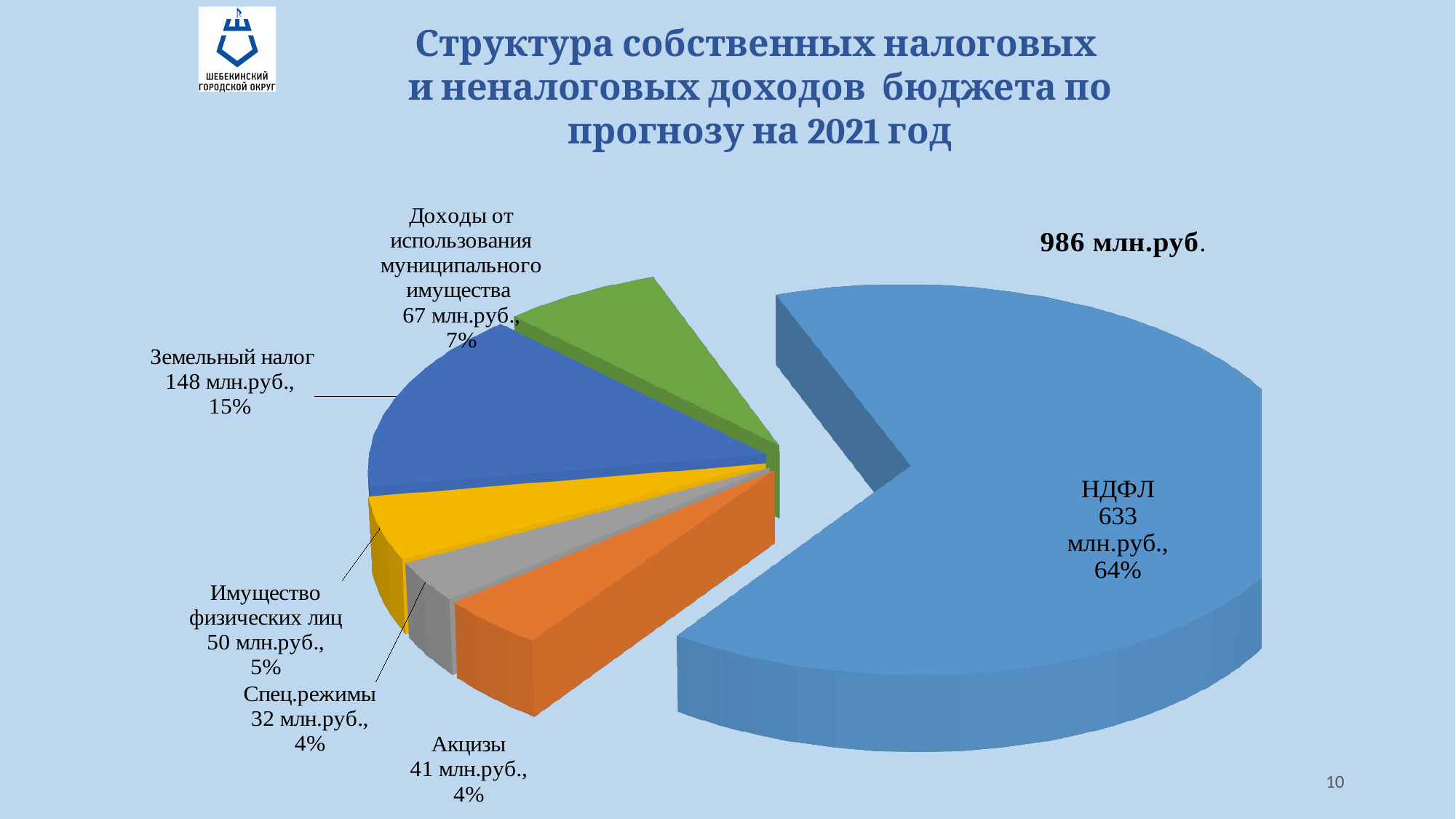
Which category has the smallest value? Спец.режимы Which category has the largest slice? НДФЛ How many slices does the pie chart have? 6 What is the value for Акцизы? 41 млн.руб. Which is larger, the value for Акцизы or the value for Спец.режимы? Акцизы What share of the pie does Доходы от использования муниципального имущества represent? 7% What total amount is shown on the slide for all own tax and non-tax revenues? 986 млн.руб. What is the value for НДФЛ? 633 млн.руб. What share of the pie does Земельный налог represent? 15% What colour is the НДФЛ slice? blue What type of chart is shown on the slide? pie chart What is the difference between the values for Земельный налог and Имущество физических лиц? 98 млн.руб.